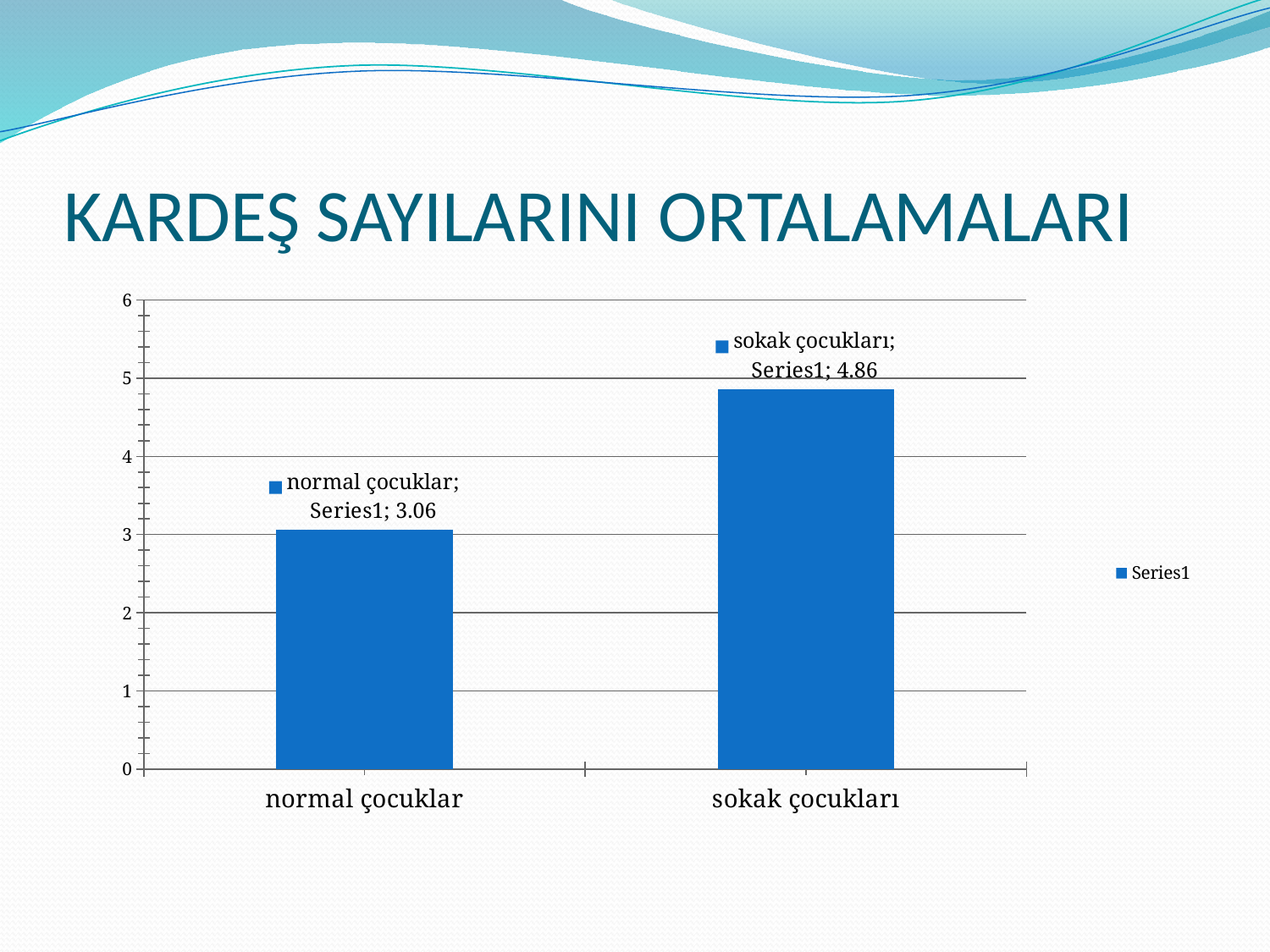
How many series does the legend list? 1 What is the difference between the values for sokak çocukları and normal çocuklar? 1.80 Is the value for normal çocuklar greater or less than 4? less Which category has the highest value? sokak çocukları How many categories are shown on the x axis? 2 Is the value for sokak çocukları greater or less than 4? greater What is the title of the slide? KARDEŞ SAYILARINI ORTALAMALARI Which is larger, the value for normal çocuklar or the value for sokak çocukları? sokak çocukları What is the value for normal çocuklar? 3.06 What is the value for sokak çocukları? 4.86 What kind of chart is shown on the slide? bar chart Which category has the lowest value? normal çocuklar